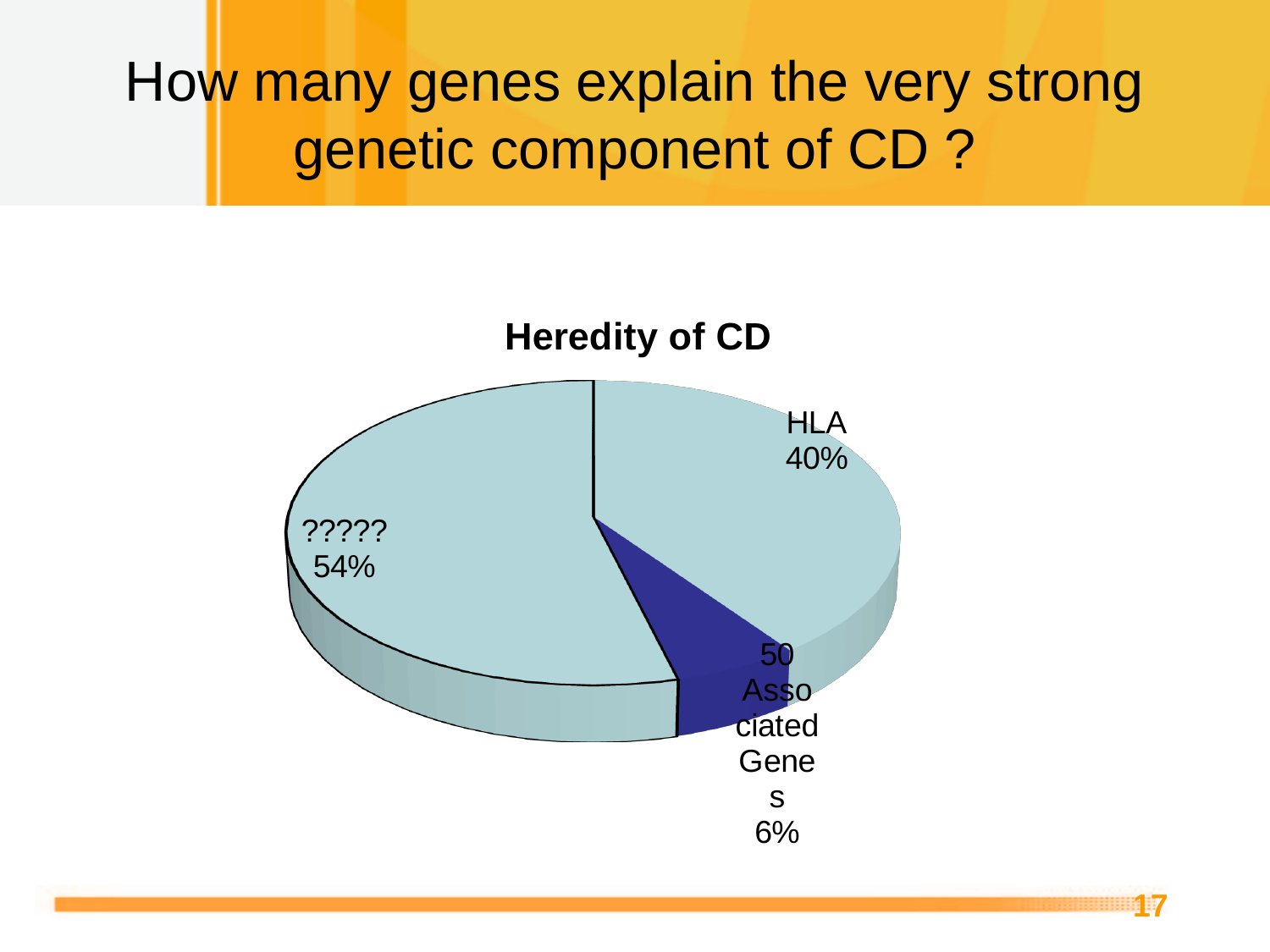
What is the difference in percentage points between the ????? slice and the HLA slice? 14 What is the title of the chart? Heredity of CD Which slice of the pie is coloured dark blue? 50 Associated Genes What is the difference in percentage points between the HLA slice and the 50 Associated Genes slice? 34 What percentage of the pie is labelled HLA? 40% Which is larger, the HLA slice or the 50 Associated Genes slice? HLA Which slice of the pie is the smallest? 50 Associated Genes What percentage of the pie is labelled 50 Associated Genes? 6% How many slices does the pie chart have? 3 What kind of chart is shown on the slide? pie chart What percentage of the pie is labelled ????? 54% Which slice of the pie is the largest? ?????